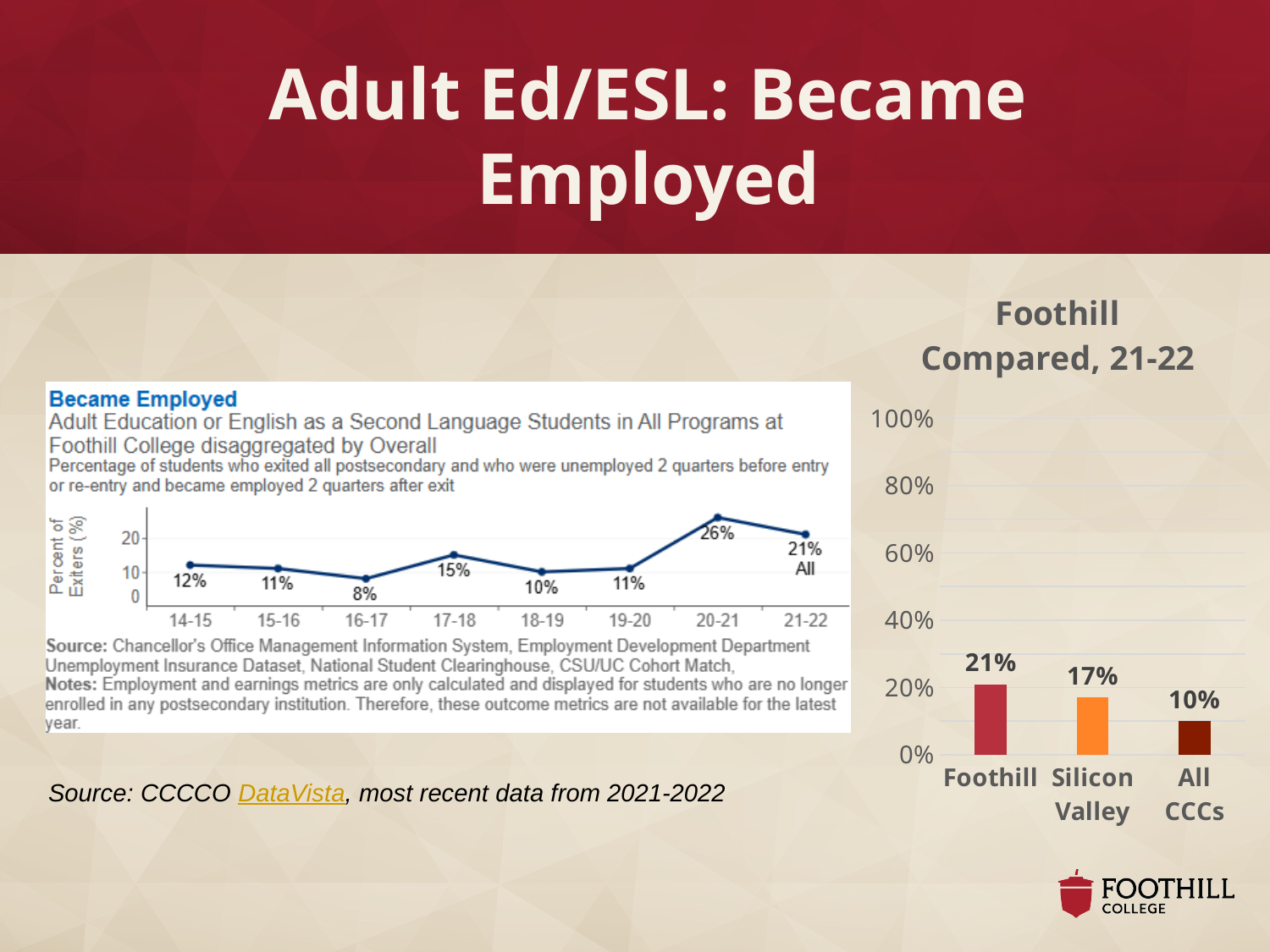
What kind of chart is the 'Foothill Compared, 21-22' chart? bar chart In the 'Became Employed' line chart, which is larger, the value for 17-18 or the value for 18-19? 17-18 In the 'Foothill Compared, 21-22' bar chart, what is the value for Foothill? 21% In the 'Foothill Compared, 21-22' bar chart, what is the difference between Foothill and All CCCs? 11% In the 'Foothill Compared, 21-22' bar chart, how many categories are shown? 3 In the 'Became Employed' line chart, what is the value for 20-21? 26% In the 'Foothill Compared, 21-22' bar chart, which category has the lowest value? All CCCs In the 'Foothill Compared, 21-22' bar chart, what is the value for Silicon Valley? 17% In the 'Became Employed' line chart, how many years are plotted? 8 In the 'Became Employed' line chart, which year has the highest value? 20-21 In the 'Became Employed' line chart, what is the difference between the 20-21 value and the 21-22 value? 5% In the 'Became Employed' line chart, what is the value for 16-17? 8%